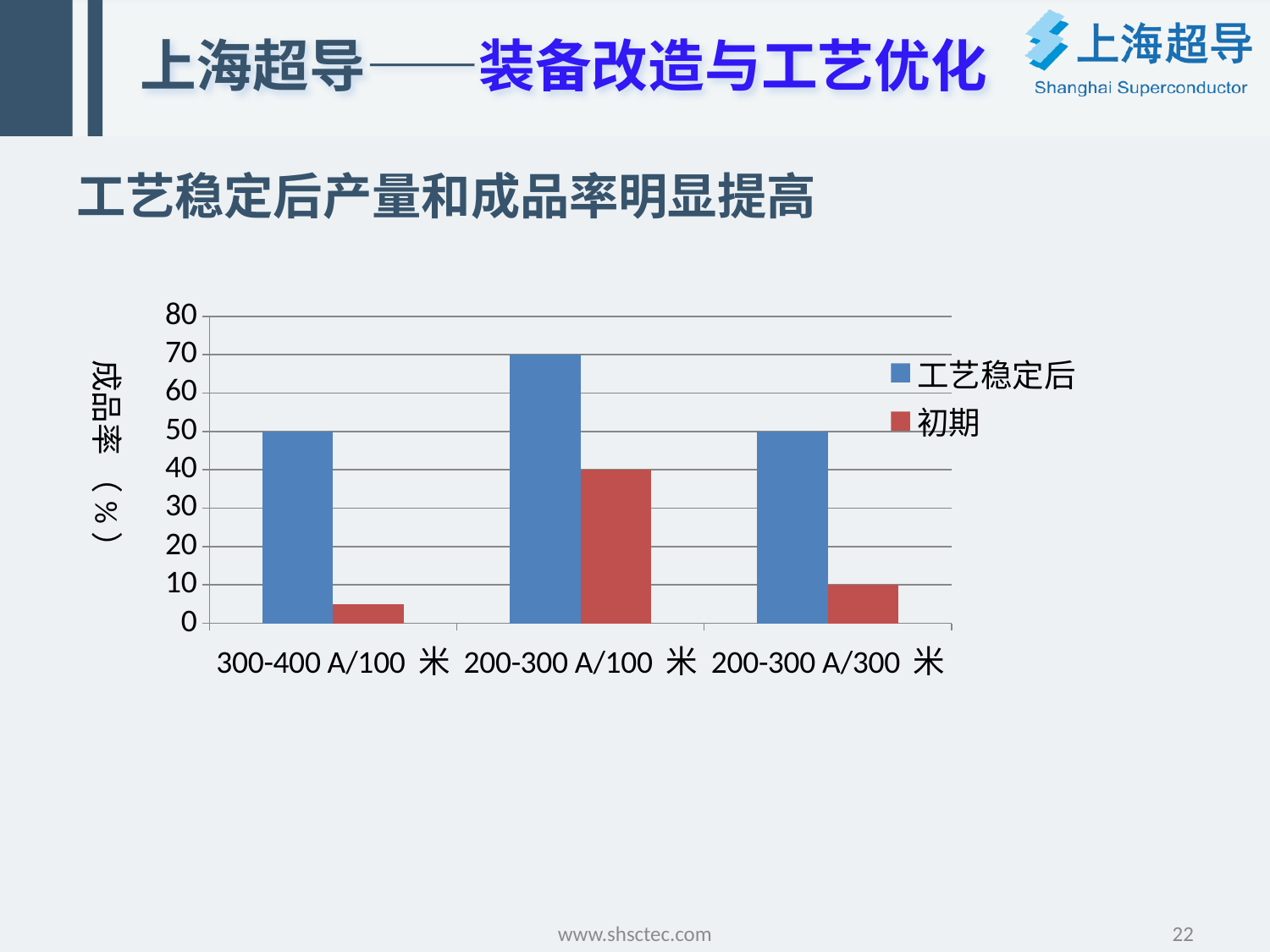
For 200-300 A/300 米, which series has the larger value, 工艺稳定后 or 初期? 工艺稳定后 What is the value of 工艺稳定后 for 200-300 A/100 米? 70 Which category has the lowest value for 初期? 300-400 A/100 米 Is the value of 初期 for 300-400 A/100 米 greater or less than 10? less What is the value of 初期 for 200-300 A/100 米? 40 How many categories are shown on the x axis? 3 What is the value of 工艺稳定后 for 300-400 A/100 米? 50 Which category has the highest value for 工艺稳定后? 200-300 A/100 米 What is the difference between 工艺稳定后 and 初期 for 200-300 A/100 米? 30 What is the value of 初期 for 200-300 A/300 米? 10 What kind of chart is shown on the slide? bar chart How many series does the legend list? 2